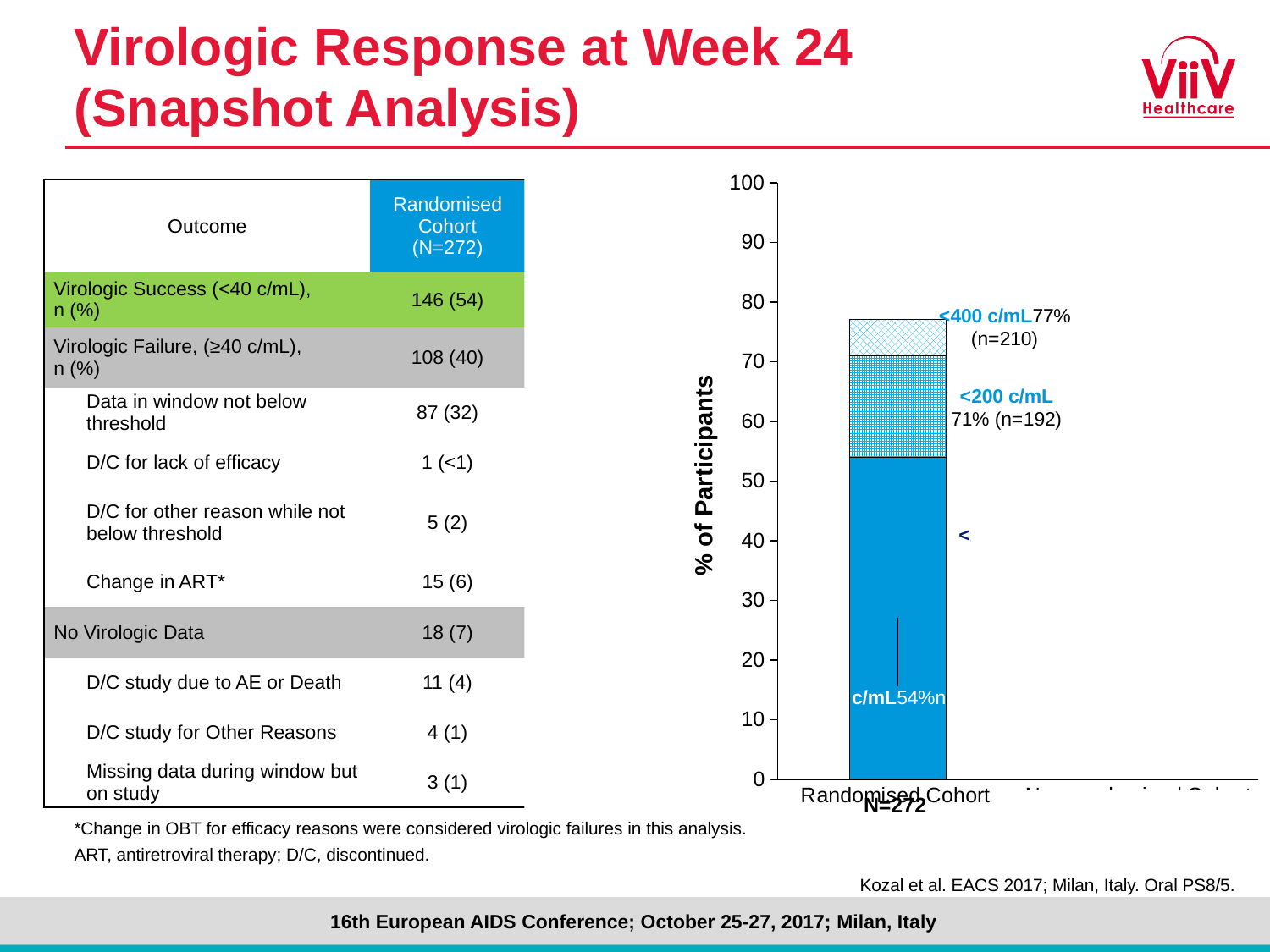
In the chart, what is the n value shown for <200 c/mL? n=192 What percentage is labelled on the solid blue bottom segment of the bar? 54% Is the top of the Randomised Cohort bar greater or less than 80 on the y axis? less What is the label of the y axis of the chart? % of Participants What is the N shown under the Randomised Cohort bar in the chart? N=272 In the chart, what is the n value shown for <400 c/mL? n=210 What kind of chart is shown on the right of the slide? bar chart In the chart, what percentage of participants is labelled for <400 c/mL? 77% In the chart, what percentage of participants is labelled for <200 c/mL? 71% Which has the higher percentage in the chart, <400 c/mL or <200 c/mL? <400 c/mL What is the difference in percentage points between the <400 c/mL (77%) and <200 c/mL (71%) labels? 6 How many bars are plotted in the chart? 1